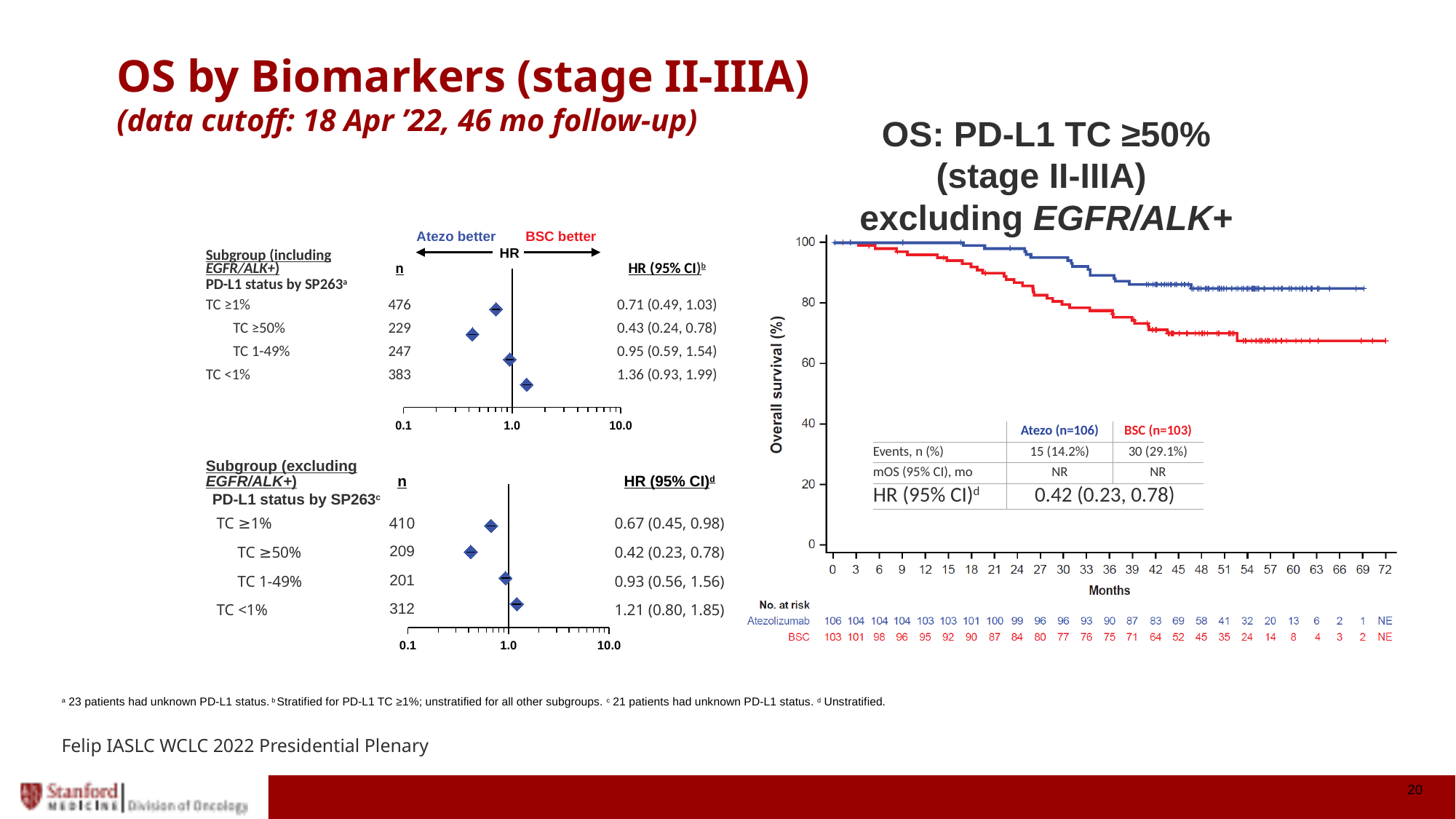
In the forest plot for the subgroup including EGFR/ALK+, what is the difference in n between the TC ≥1% and TC <1% subgroups? 93 In the forest plot for the subgroup excluding EGFR/ALK+, which PD-L1 subgroup has the lowest hazard ratio? TC ≥50% In the forest plot for the subgroup excluding EGFR/ALK+, what is the HR (95% CI) for TC <1%? 1.21 (0.80, 1.85) In the forest plot for the subgroup including EGFR/ALK+, which PD-L1 subgroup has the highest hazard ratio? TC <1% In the Kaplan-Meier chart titled 'OS: PD-L1 TC ≥50% (stage II-IIIA) excluding EGFR/ALK+', how many events were reported in the Atezo arm? 15 (14.2%) In the forest plot for the subgroup excluding EGFR/ALK+, how many PD-L1 subgroups are plotted? 4 In the forest plot for the subgroup including EGFR/ALK+, how many patients (n) are in the TC ≥1% subgroup? 476 In the Kaplan-Meier chart titled 'OS: PD-L1 TC ≥50% (stage II-IIIA) excluding EGFR/ALK+', what is the HR (95% CI)? 0.42 (0.23, 0.78) In the Kaplan-Meier chart titled 'OS: PD-L1 TC ≥50% (stage II-IIIA) excluding EGFR/ALK+', how many BSC patients were at risk at 36 months? 75 In the forest plot for the subgroup including EGFR/ALK+, is the hazard ratio for TC ≥50% greater or less than 1.0? less In the Kaplan-Meier chart titled 'OS: PD-L1 TC ≥50% (stage II-IIIA) excluding EGFR/ALK+', which arm has the higher overall survival at 48 months, Atezo or BSC? Atezo In the forest plot for the subgroup including EGFR/ALK+, what is the HR (95% CI) for TC ≥50%? 0.43 (0.24, 0.78)